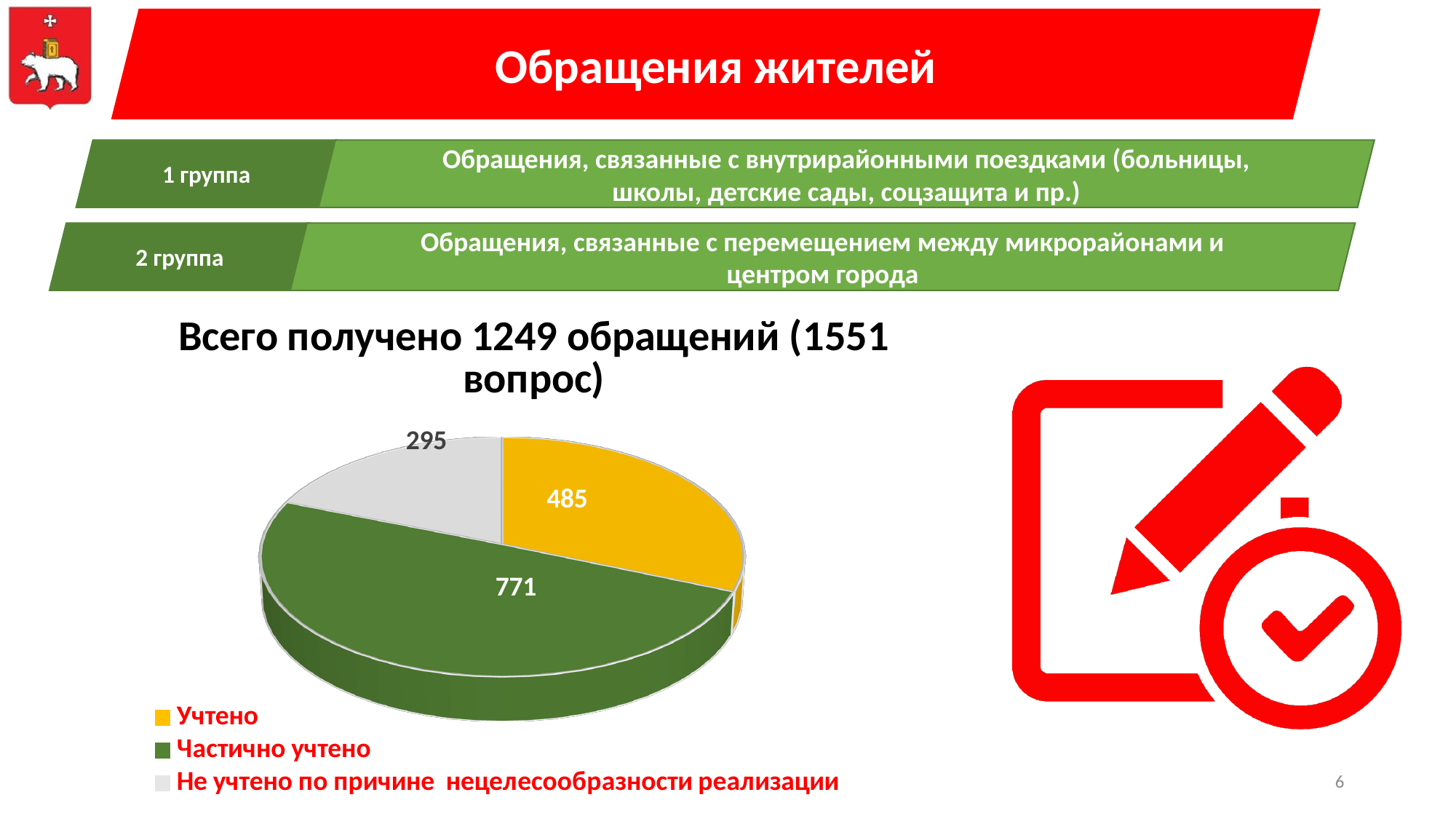
What is the total of all three slices in the pie chart? 1551 What is the title of the pie chart? Всего получено 1249 обращений (1551 вопрос) What is the value for "Не учтено по причине нецелесообразности реализации" in the pie chart? 295 Which is larger: the value for "Учтено" or the value for "Не учтено по причине нецелесообразности реализации"? Учтено Which category has the smallest slice in the pie chart? Не учтено по причине нецелесообразности реализации Which category has the largest slice in the pie chart? Частично учтено What is the value for "Учтено" in the pie chart? 485 What is the difference between the values for "Учтено" and "Не учтено по причине нецелесообразности реализации"? 190 What is the value for "Частично учтено" in the pie chart? 771 How many slices does the pie chart have? 3 What kind of chart is shown on the slide? Pie chart What is the difference between the values for "Частично учтено" and "Учтено"? 286